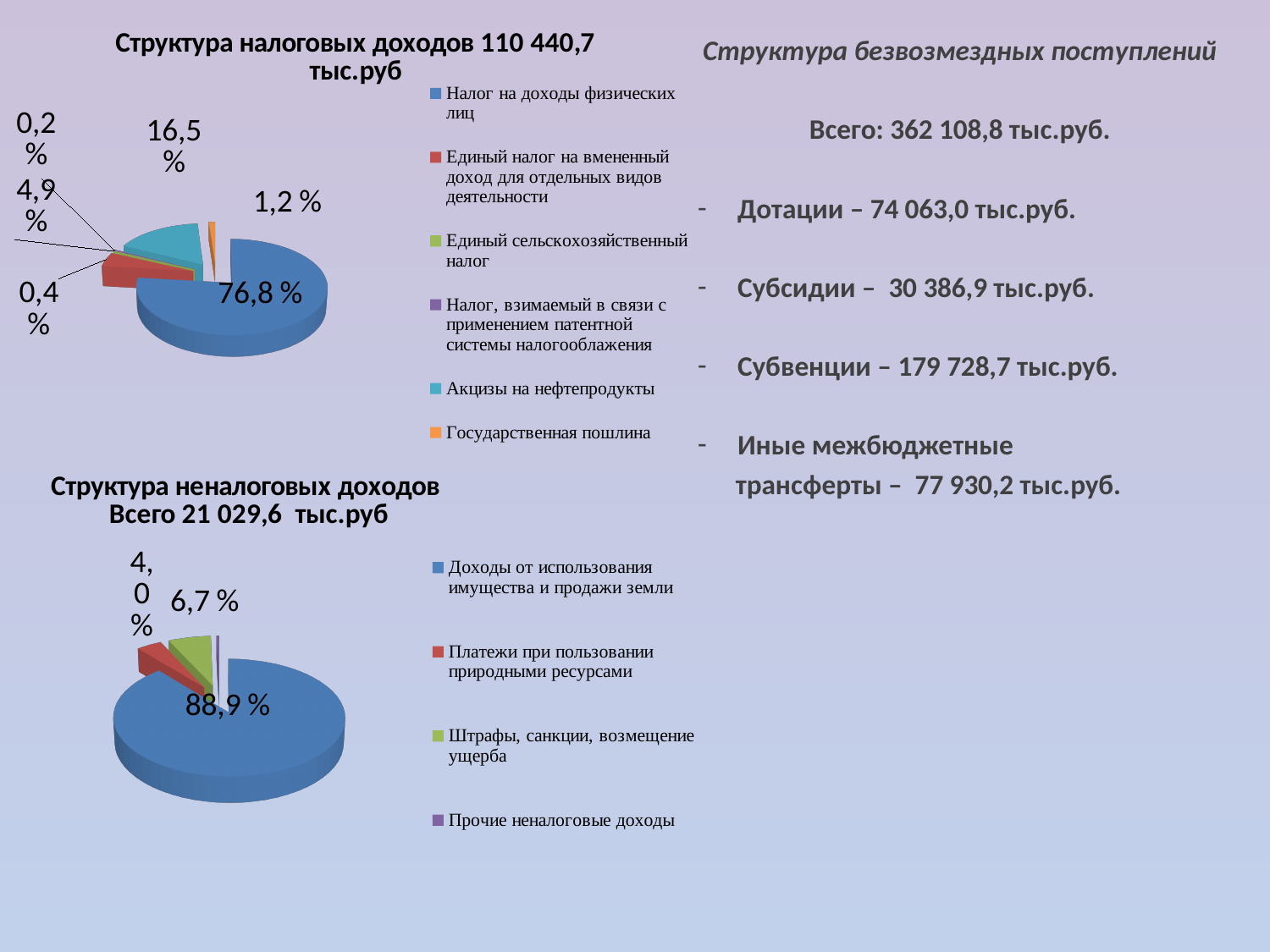
In the chart 'Структура налоговых доходов', how many categories does the legend list? 6 In the chart 'Структура налоговых доходов', what is the difference between the shares of Налог на доходы физических лиц and Акцизы на нефтепродукты? 60,3 % In the chart 'Структура налоговых доходов', what share is shown for Государственная пошлина? 1,2 % What type of chart is 'Структура налоговых доходов'? Pie chart In the chart 'Структура неналоговых доходов', which category has the largest share? Доходы от использования имущества и продажи земли In the chart 'Структура налоговых доходов', what share is shown for Налог на доходы физических лиц? 76,8 % In the chart 'Структура налоговых доходов', what is the smallest percentage label shown? 0,2 % In the chart 'Структура налоговых доходов', what share is shown for Акцизы на нефтепродукты? 16,5 % In the chart 'Структура неналоговых доходов', what share is shown for Доходы от использования имущества и продажи земли? 88,9 % What total amount is stated in the title of the chart 'Структура неналоговых доходов'? 21 029,6 тыс.руб In the chart 'Структура налоговых доходов', which category has the largest share? Налог на доходы физических лиц In the chart 'Структура неналоговых доходов', how many categories does the legend list? 4